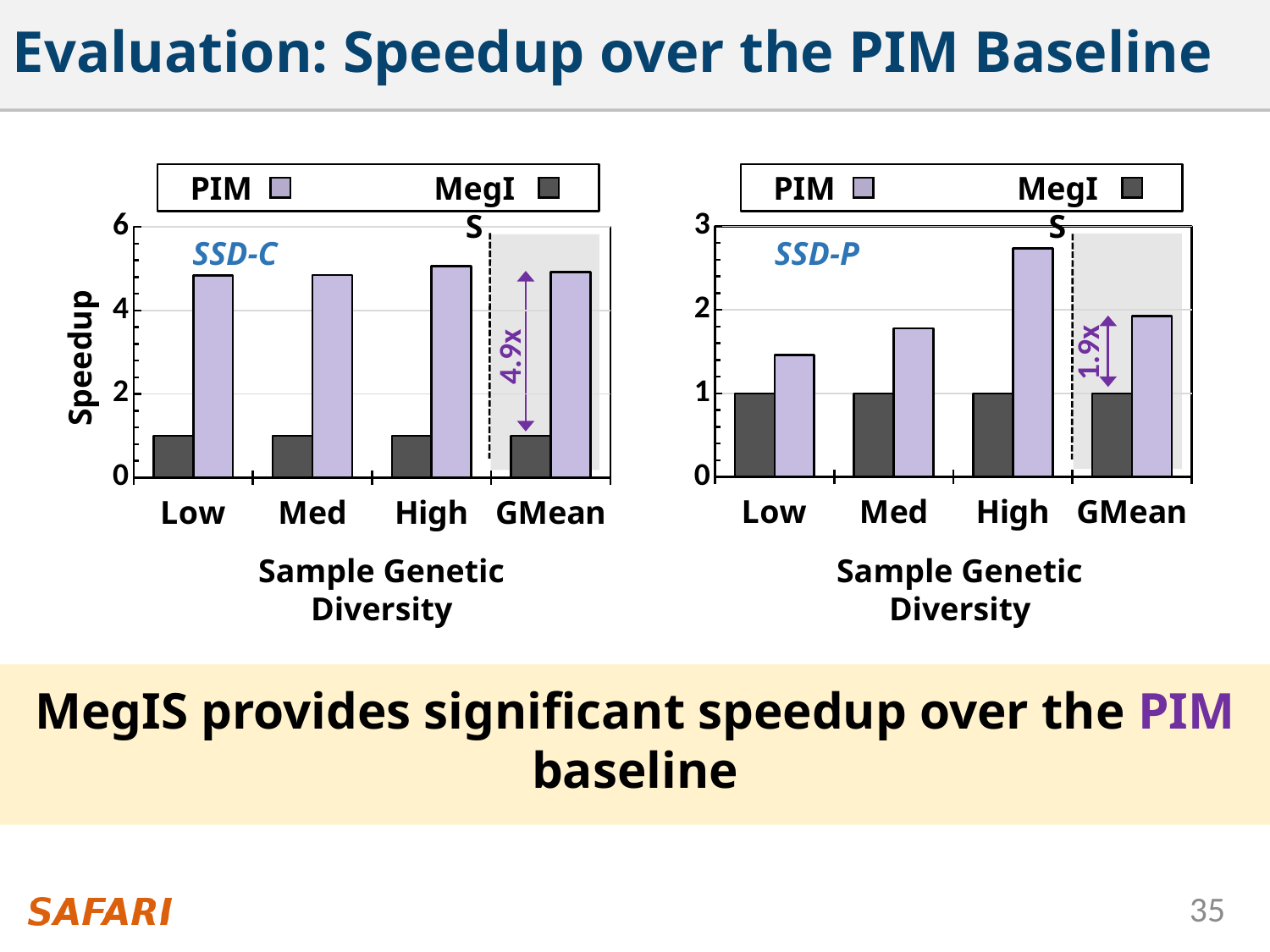
In the SSD-P chart, what speedup is annotated for the GMean category? 1.9x In the SSD-P chart, is the taller (purple) bar for Low greater or less than 2? less In the SSD-P chart, do the purple bars rise or fall from Low to High? rise What kind of chart is the SSD-C chart on the left? bar chart How many series does the legend of the SSD-P chart list? 2 In the SSD-C chart, what speedup is annotated for the GMean category? 4.9x In the SSD-P chart, is the taller (purple) bar for High greater or less than 2? greater What is the y-axis label of the SSD-C chart? Speedup How many categories are shown on the x axis of the SSD-C chart? 4 Which chart shows the larger annotated GMean speedup, SSD-C or SSD-P? SSD-C In the SSD-C chart, is the taller (purple) bar for Low greater or less than 4? greater In the SSD-P chart, which of Low, Med and High has the tallest bar? High